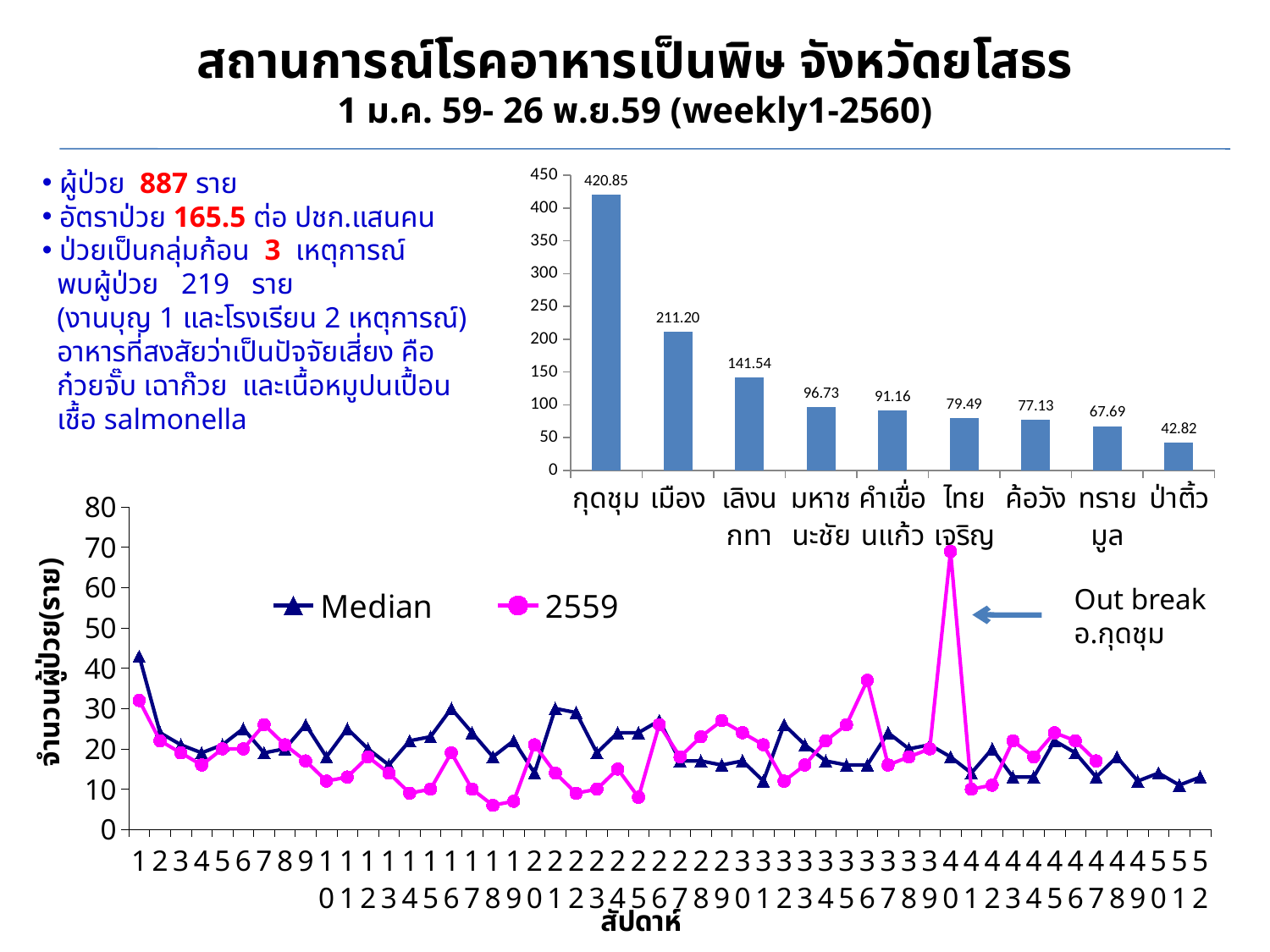
In the line chart at the bottom, is the value of the 2559 series at week 40 greater or less than 60? greater In the bar chart at the top right, what is the value for เลิงนกทา? 141.54 In the bar chart at the top right, what is the difference between the values for กุดชุม and เมือง? 209.65 In the line chart at the bottom, what are the two series named in the legend? Median and 2559 What kind of chart is the chart at the top right of the slide? bar chart In the bar chart at the top right, which category has the highest value? กุดชุม How many categories are shown in the bar chart at the top right? 9 In the bar chart at the top right, what is the value for ป่าติ้ว? 42.82 In the bar chart at the top right, what is the value for กุดชุม? 420.85 In the bar chart at the top right, which category has the lowest value? ป่าติ้ว In the bar chart at the top right, which is larger, the value for มหาชนะชัย or the value for ไทยเจริญ? มหาชนะชัย How many series does the legend of the line chart at the bottom list? 2